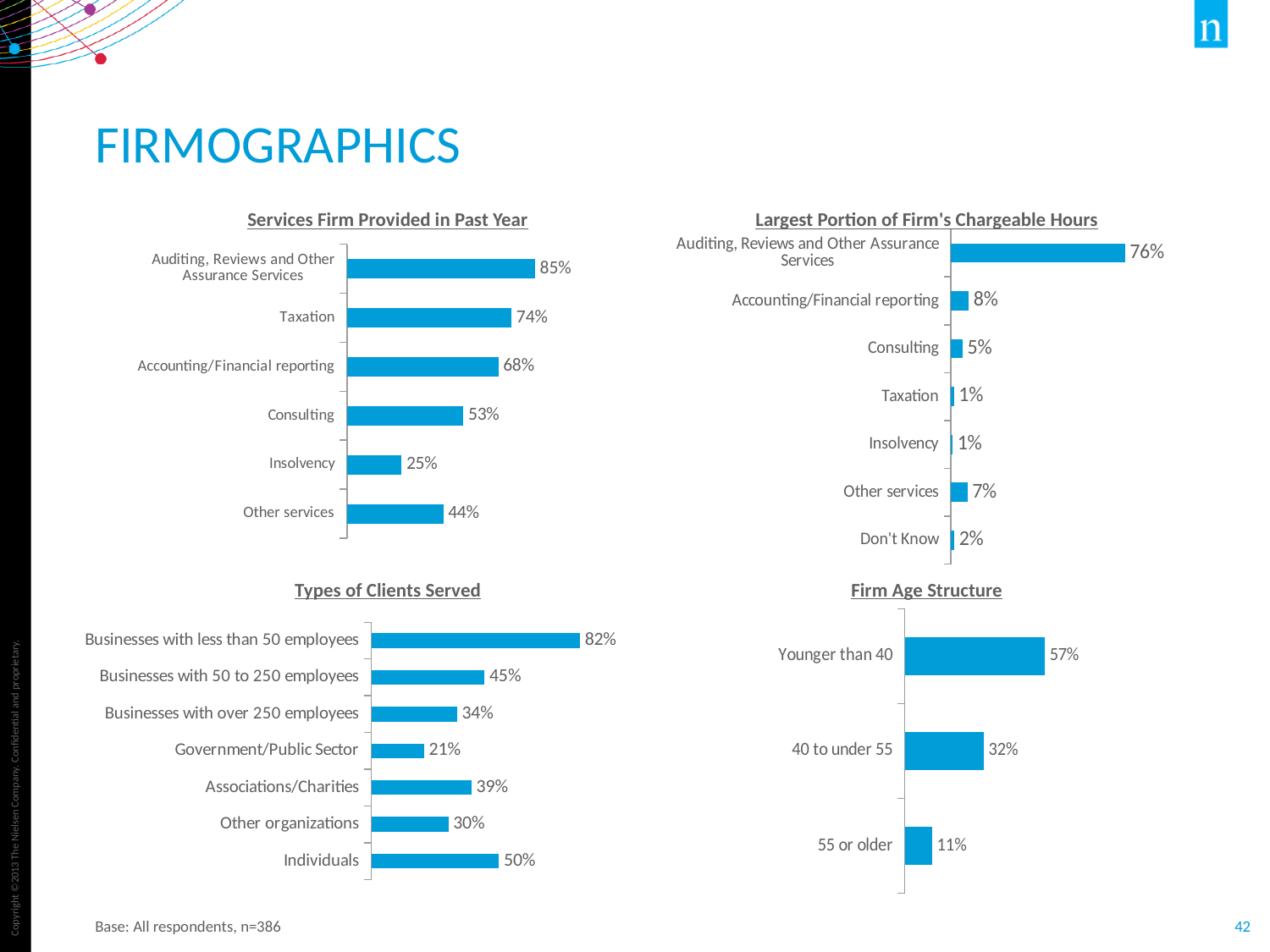
In the 'Firm Age Structure' chart, what is the value for 40 to under 55? 32% How many charts are shown on the slide? 4 In the 'Types of Clients Served' chart, what is the difference between Businesses with less than 50 employees and Individuals? 32% What type of chart is the 'Firm Age Structure' chart? Bar chart In the 'Services Firm Provided in Past Year' chart, which service has the lowest value? Insolvency In the 'Largest Portion of Firm's Chargeable Hours' chart, what is the value for Accounting/Financial reporting? 8% In the 'Services Firm Provided in Past Year' chart, what is the value for Taxation? 74% In the 'Types of Clients Served' chart, which is larger: Associations/Charities or Other organizations? Associations/Charities In the 'Types of Clients Served' chart, what is the value for Government/Public Sector? 21% In the 'Largest Portion of Firm's Chargeable Hours' chart, which category has the highest value? Auditing, Reviews and Other Assurance Services In the 'Services Firm Provided in Past Year' chart, what is the difference between Auditing, Reviews and Other Assurance Services and Consulting? 32% How many categories are shown in the 'Largest Portion of Firm's Chargeable Hours' chart? 7